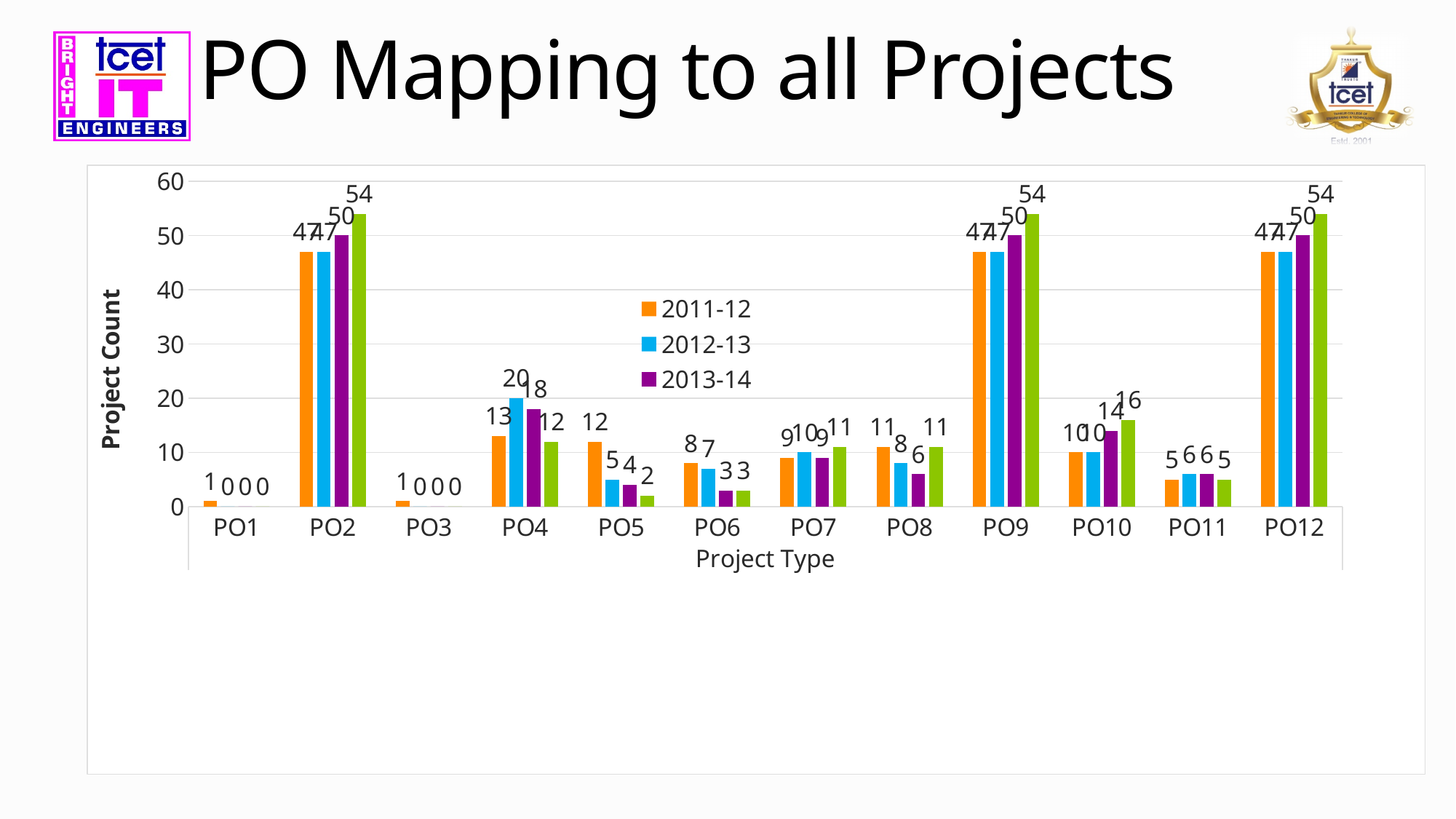
How many series does the legend list? 3 What is the difference between the 2012-13 and 2011-12 values at PO4? 7 Is the value for 2013-14 at PO9 greater or less than 40? greater How many project types (categories) are shown on the x axis? 12 Which series has the highest value at PO4? 2012-13 What kind of chart is shown on the slide? bar chart What is the value for 2013-14 at PO4? 18 What is the value for 2012-13 at PO10? 10 What is the title of the y axis? Project Count Which series has the highest value at PO6? 2011-12 At PO8, which is larger: the 2011-12 value or the 2012-13 value? 2011-12 What is the value for 2011-12 at PO5? 12